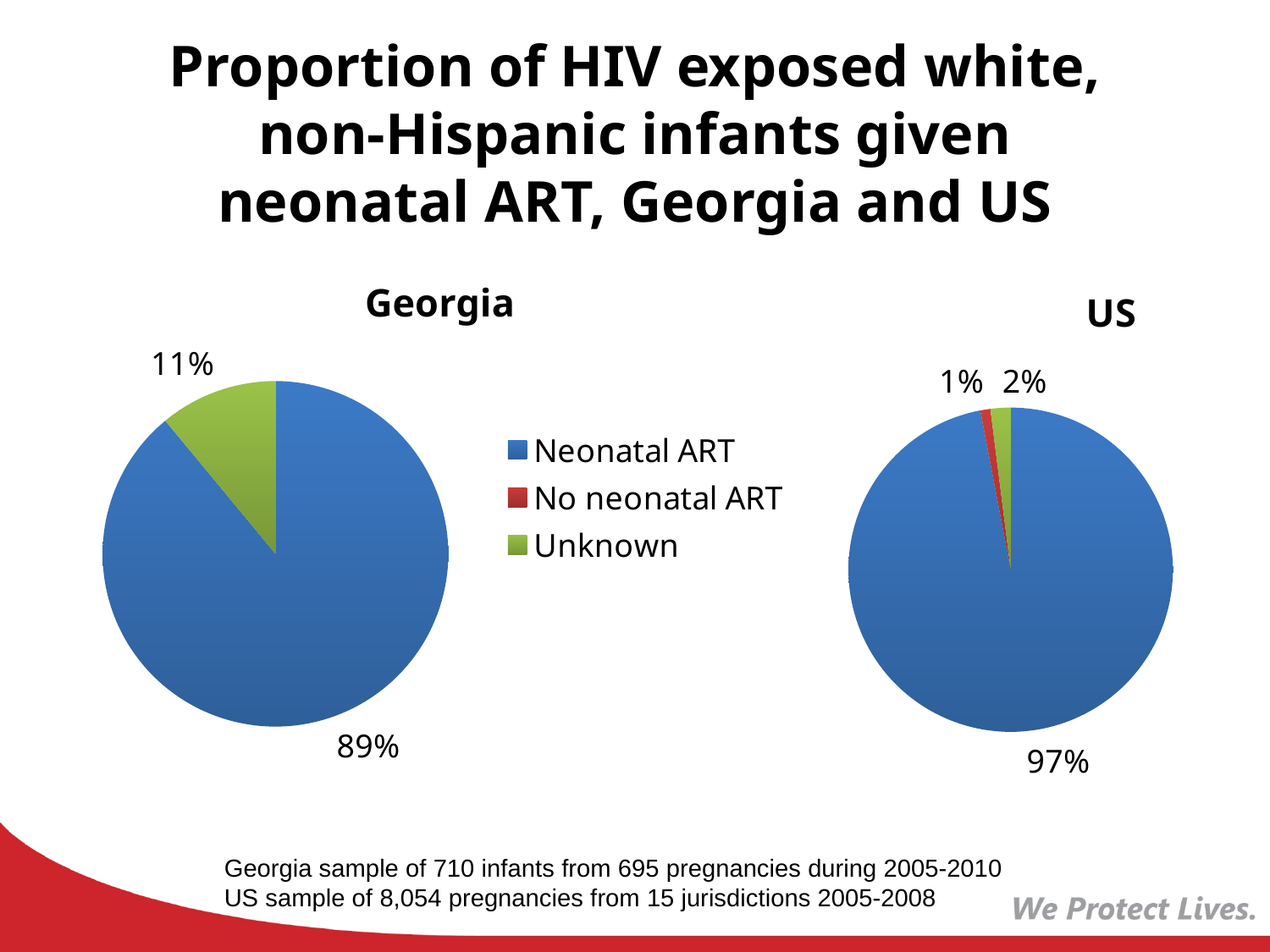
Which colour represents Unknown in the pie charts? Green In the Georgia pie chart, which category has the largest slice? Neonatal ART In the Georgia pie chart, what share of infants is labelled Unknown? 11% In the Georgia pie chart, what share of infants were given neonatal ART? 89% How much larger is the Neonatal ART share in the US pie chart than in the Georgia pie chart? 8 percentage points What type of chart is used on this slide? Pie chart In the US pie chart, what share of infants were given neonatal ART? 97% In the US pie chart, what share of infants had no neonatal ART? 1% In the US pie chart, which category has the smallest slice? No neonatal ART How many categories does the legend list? 3 Which pie chart shows a larger Unknown share, Georgia or US? Georgia In the US pie chart, what share of infants is labelled Unknown? 2%